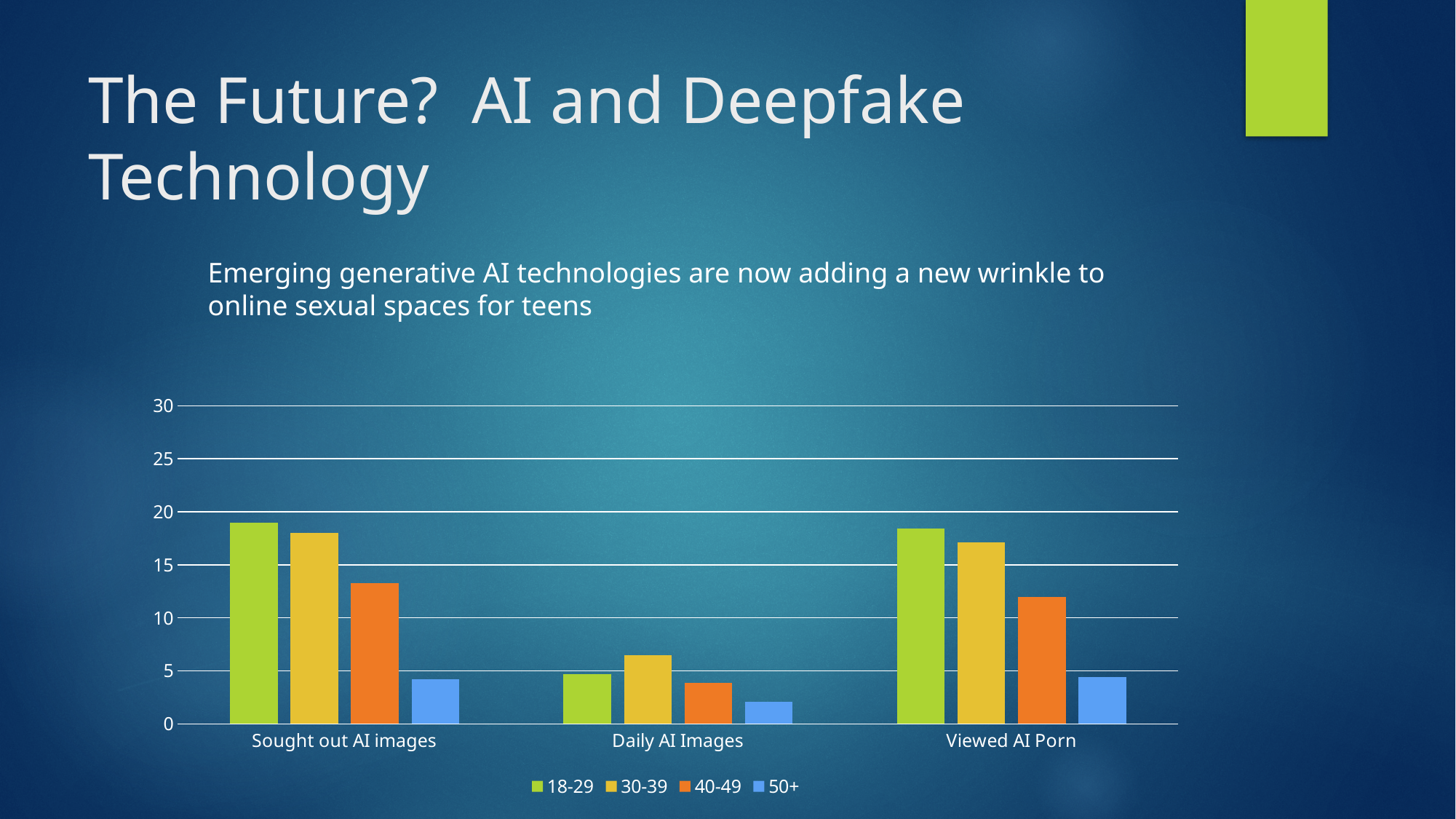
Is the value for 50+ in the Sought out AI images category greater or less than 5? less Is the value for 40-49 in the Viewed AI Porn category greater or less than 10? greater What kind of chart is shown on the slide? bar chart Is the value for 18-29 in the Sought out AI images category greater or less than 15? greater Which age group has the highest value in the Daily AI Images category? 30-39 Which age group is shown in green in the chart's legend? 18-29 Which age group has the lowest value in the Viewed AI Porn category? 50+ How many series does the chart's legend list? 4 How many categories are shown along the x axis of the chart? 3 Which is larger: the 18-29 value for Sought out AI images or the 18-29 value for Daily AI Images? Sought out AI images